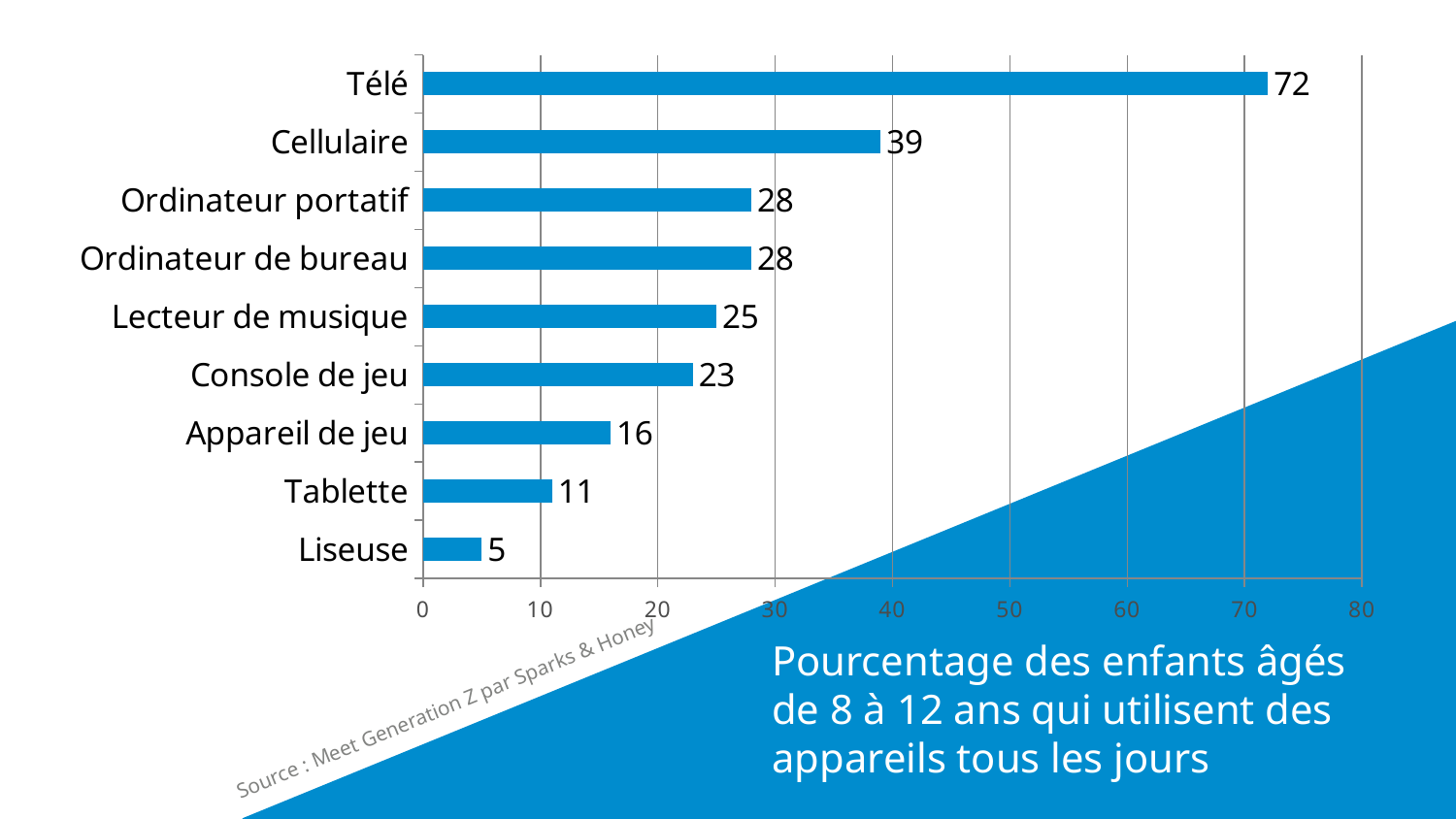
What kind of chart is shown on the slide? Bar chart How many categories are shown in the chart? 9 What is the value for Appareil de jeu? 16 What is the difference between the values for Lecteur de musique and Console de jeu? 2 What is the value for Cellulaire? 39 Which category has the highest value? Télé What is the source cited for the chart? Meet Generation Z par Sparks & Honey Which is larger, the value for Console de jeu or the value for Appareil de jeu? Console de jeu Which category has the lowest value? Liseuse What is the difference between the values for Télé and Cellulaire? 33 What is the value for Tablette? 11 What is the value for Télé? 72